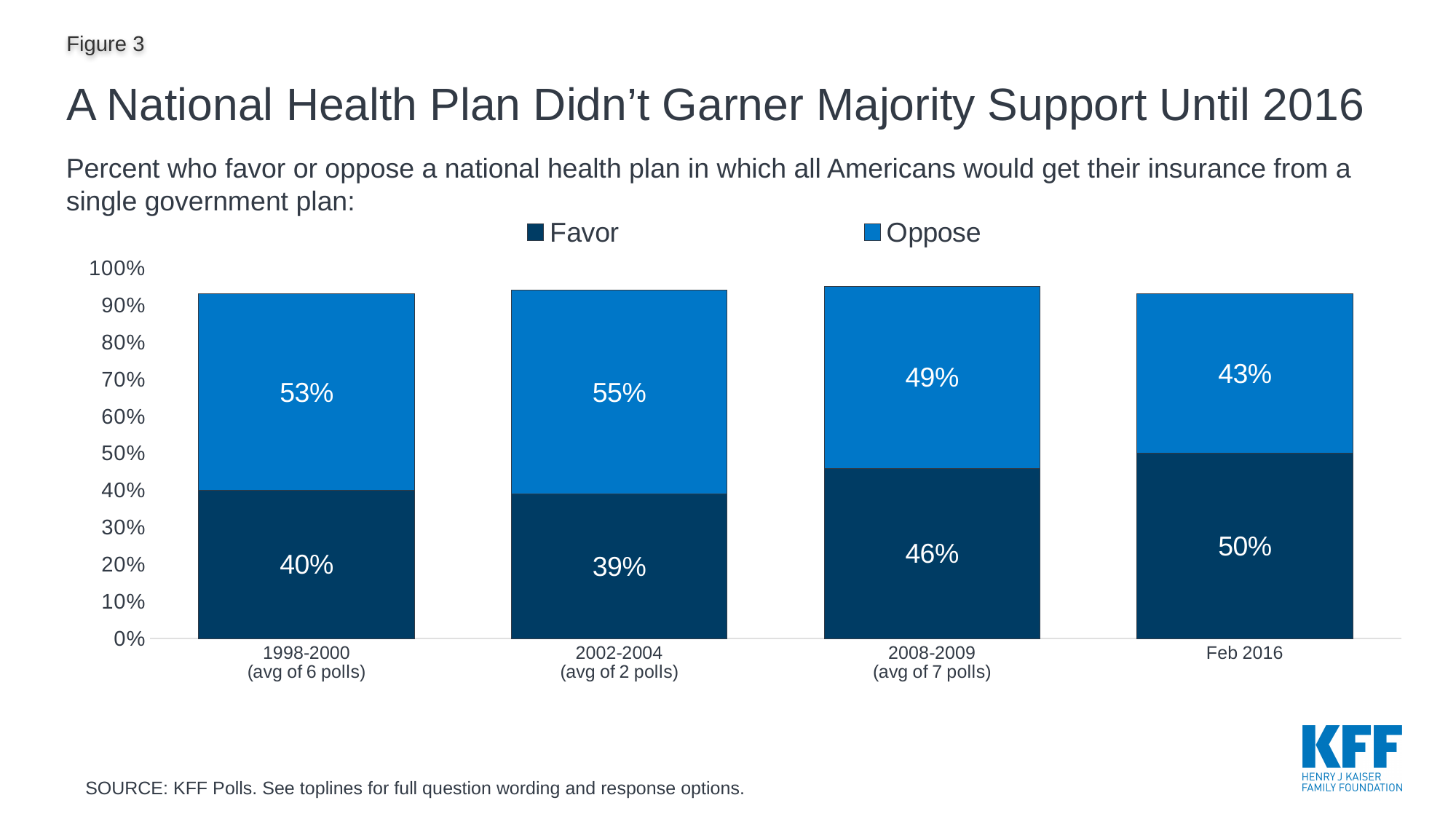
What is the combined total of Favor and Oppose for Feb 2016? 93% Which period has the highest Oppose value? 2002-2004 What is the difference between the Oppose and Favor values in 1998-2000? 13 percentage points How many time periods are shown on the x axis? 4 What kind of chart is shown? Stacked bar chart Which period has the lowest Favor value? 2002-2004 What percent opposed a national health plan in 2002-2004? 55% Is the Favor value larger in 2008-2009 or in 1998-2000? 2008-2009 Which period has the highest Favor value? Feb 2016 How many series does the legend list? 2 What percent favored a national health plan in Feb 2016? 50% What is the Favor value for 2008-2009? 46%